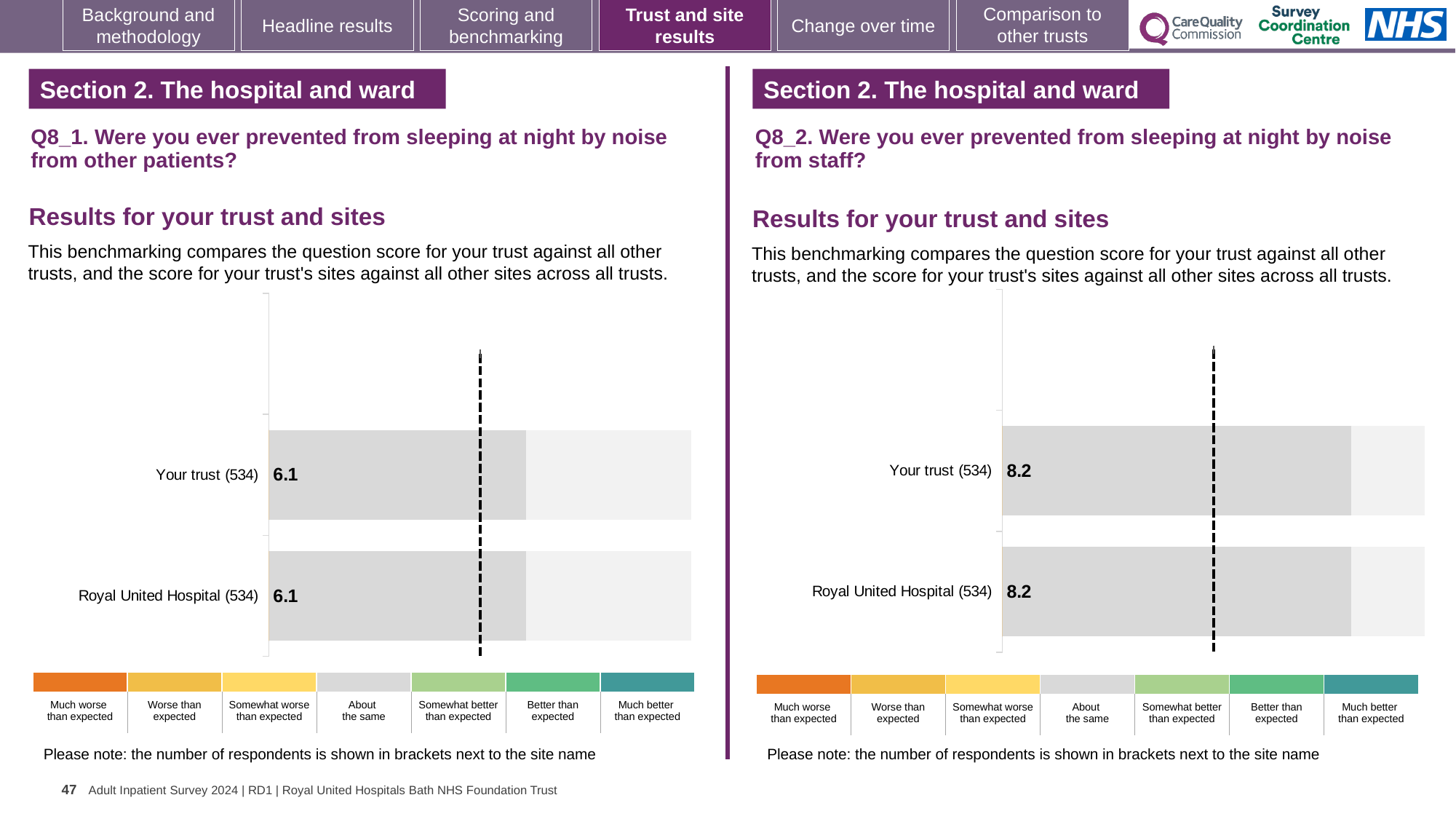
In the right chart (Q8_2, noise from staff), what is the score for Royal United Hospital (534)? 8.2 How many bars are plotted in the left chart (Q8_1)? 2 In the left chart (Q8_1), how many respondents are shown in brackets next to Royal United Hospital? 534 In the left chart (Q8_1, noise from other patients), what is the score for Your trust (534)? 6.1 In the right chart (Q8_2, noise from staff), what is the score for Your trust (534)? 8.2 How many benchmark categories are listed in the colour key below the right chart (Q8_2)? 7 How many bars are plotted in the right chart (Q8_2)? 2 In the right chart (Q8_2), what is the difference between the score for Your trust and the score for Royal United Hospital? 0.0 In the left chart (Q8_1, noise from other patients), what is the score for Royal United Hospital (534)? 6.1 What kind of chart is used on the right side of the slide for Q8_2? Bar chart In the left chart (Q8_1), what is the difference between the score for Your trust and the score for Royal United Hospital? 0.0 What kind of chart is used on the left side of the slide for Q8_1? Bar chart